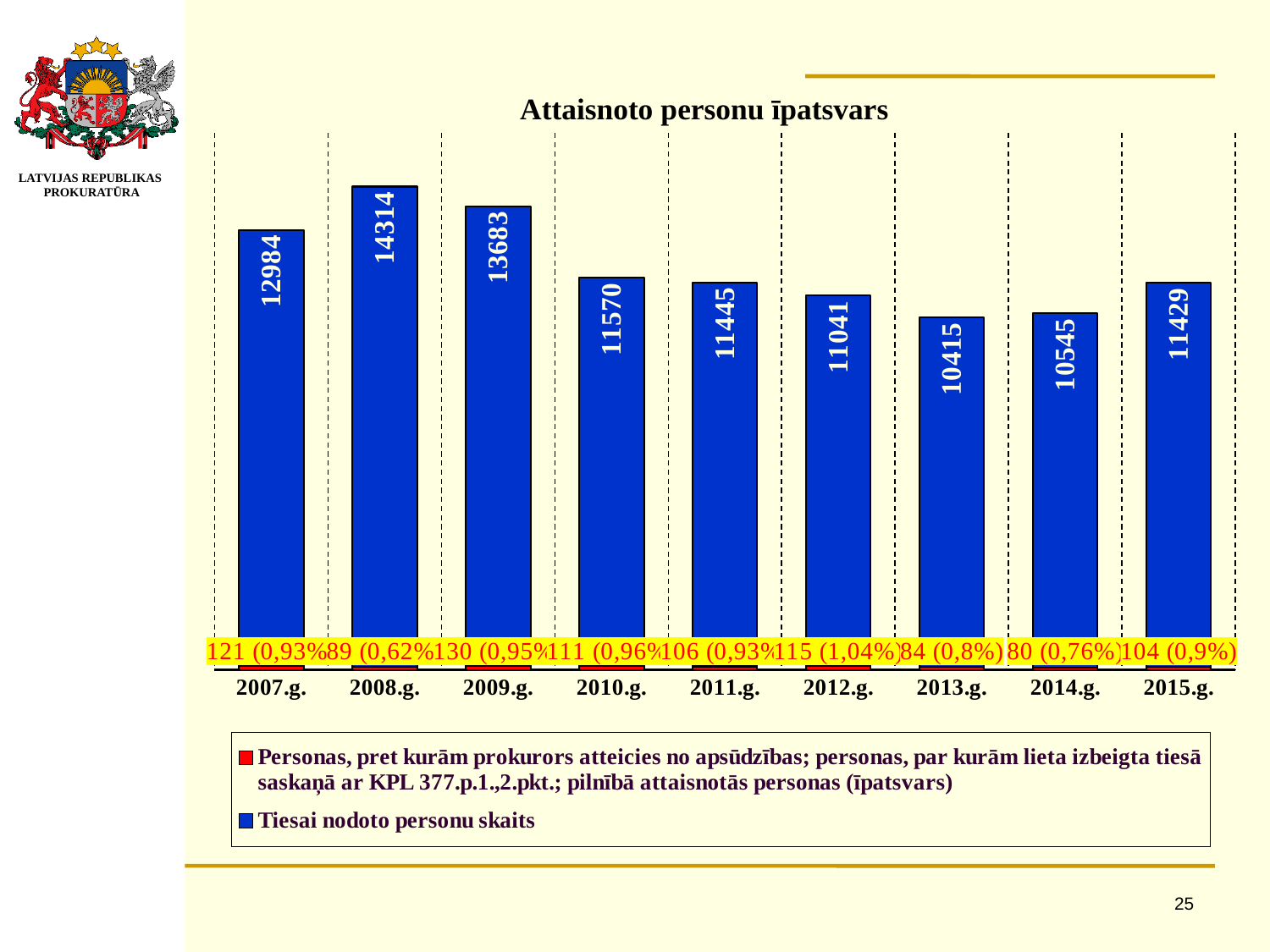
Which year has the highest value of 'Tiesai nodoto personu skaits'? 2008.g. What label is shown for the red series in 2012.g.? 115 (1,04%) Does the value of 'Tiesai nodoto personu skaits' rise or fall from 2008.g. to 2013.g.? fall What is the difference between the 'Tiesai nodoto personu skaits' values for 2008.g. and 2007.g.? 1330 What is the value of 'Tiesai nodoto personu skaits' for 2015.g.? 11429 What is the value of 'Tiesai nodoto personu skaits' for 2008.g.? 14314 Which year has the lowest value of 'Tiesai nodoto personu skaits'? 2013.g. What kind of chart is shown on the slide? bar chart Which year has the larger 'Tiesai nodoto personu skaits' value, 2009.g. or 2010.g.? 2009.g. How many years (categories) are shown on the x axis of the chart? 9 What is the title of the chart? Attaisnoto personu īpatsvars How many series does the chart legend list? 2